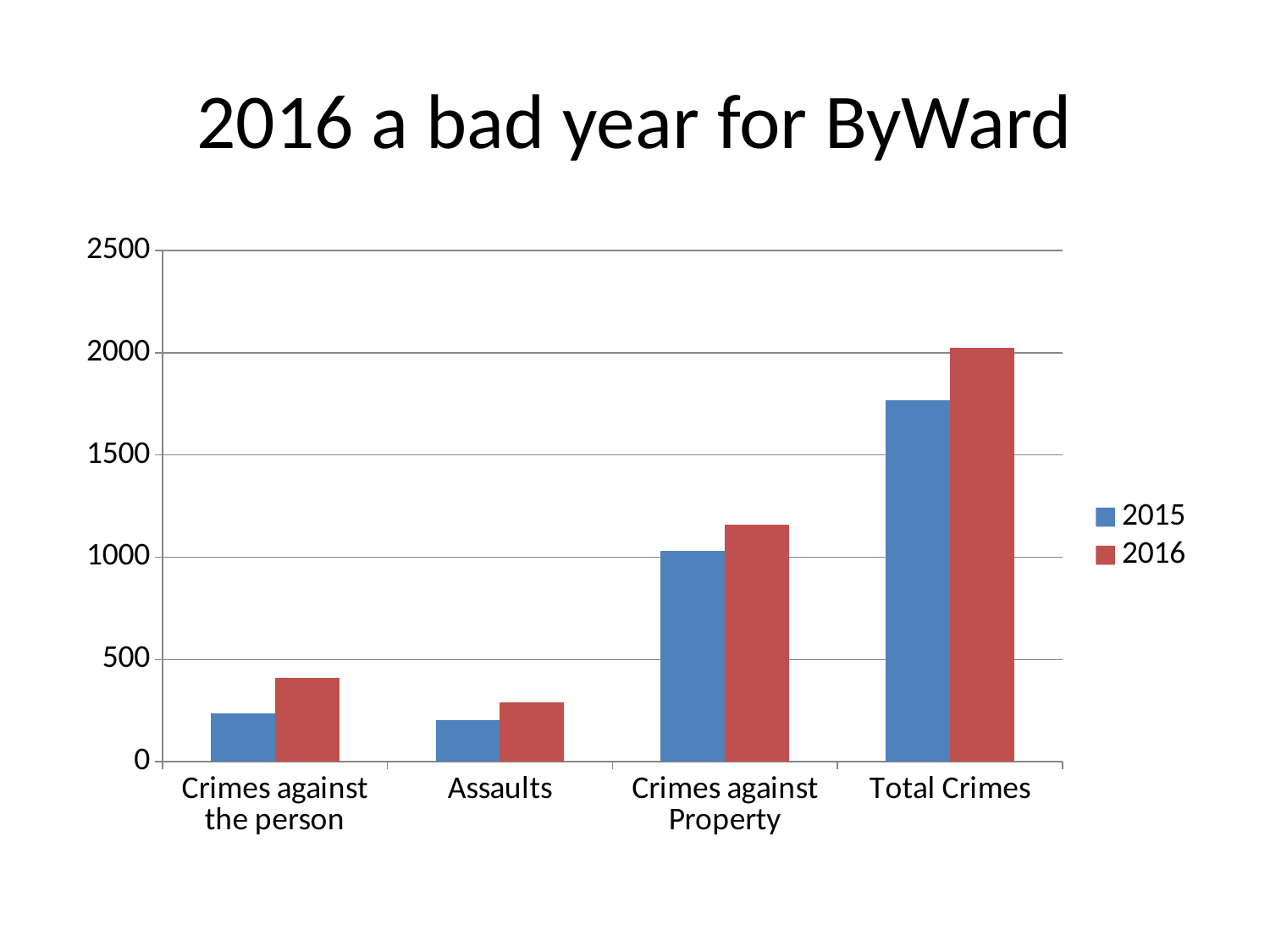
Is the value for Crimes against the person in 2016 greater or less than 500? less Which category has the highest value for 2016? Total Crimes For Crimes against Property, which year has the larger value, 2015 or 2016? 2016 Which colour represents the 2016 series in the legend? red Is the value for Total Crimes in 2016 greater or less than 1500? greater Is the value for Total Crimes in 2015 greater or less than 2000? less How many categories are shown on the x axis? 4 What kind of chart is shown on the slide? bar chart Which category has the lowest value for 2015? Assaults How many series does the legend list? 2 For Assaults, which year has the larger value, 2015 or 2016? 2016 What is the title of the slide? 2016 a bad year for ByWard